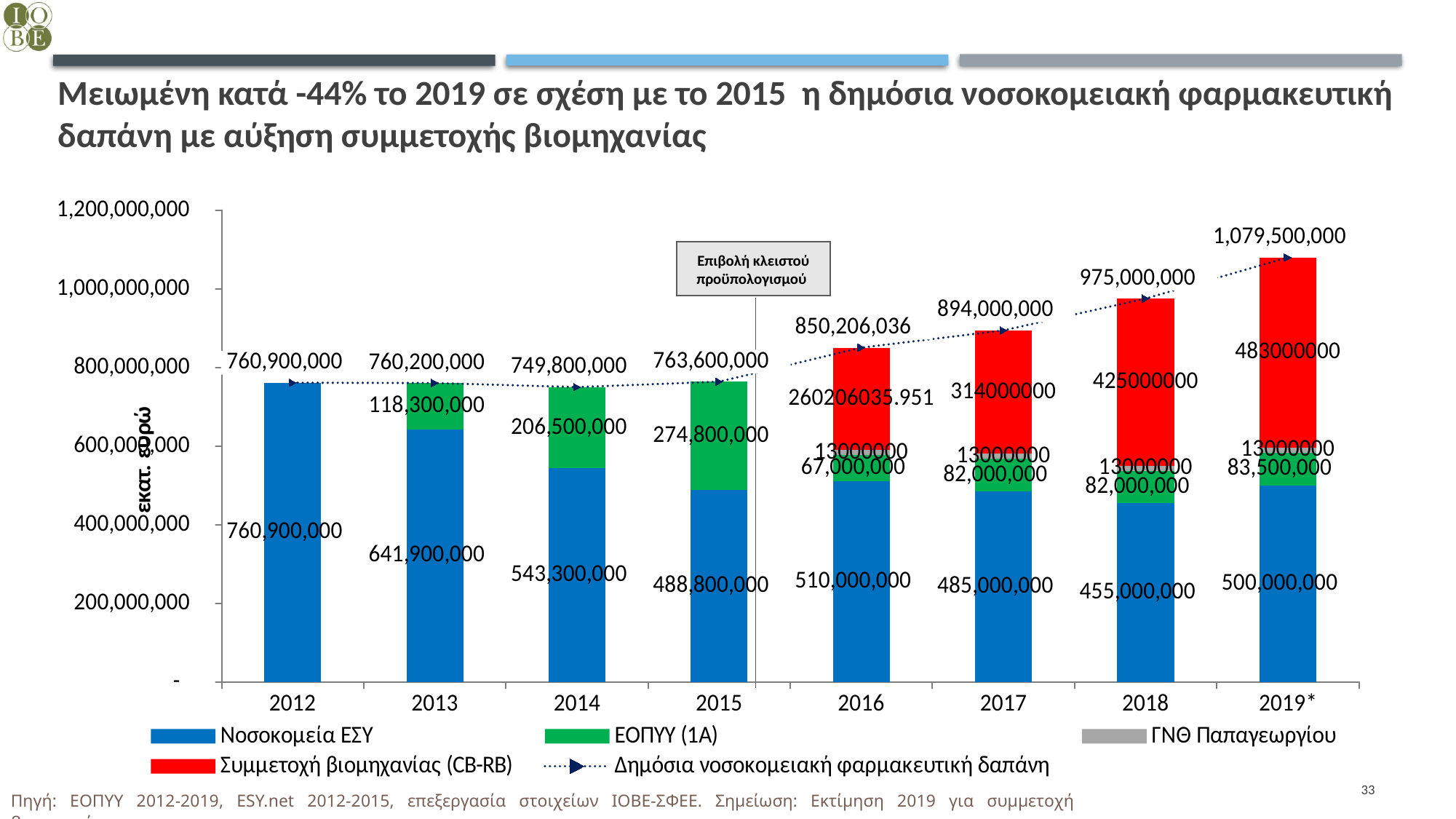
What is the value for ΕΟΠΥΥ (1Α) in 2015? 274,800,000 How many series does the legend list? 5 In which year is the Δημόσια νοσοκομειακή φαρμακευτική δαπάνη line highest? 2019* What is the value for Συμμετοχή βιομηχανίας (CB-RB) in 2019*? 483000000 What is the value for ΓΝΘ Παπαγεωργίου in 2017? 13000000 In which year is the value for Νοσοκομεία ΕΣΥ lowest? 2018 Does the value for Νοσοκομεία ΕΣΥ rise or fall from 2012 to 2015? fall What is the difference between the Νοσοκομεία ΕΣΥ values for 2012 and 2013? 119,000,000 How many years are shown on the x axis? 8 What is the value for Νοσοκομεία ΕΣΥ in 2012? 760,900,000 Which year has the larger ΕΟΠΥΥ (1Α) value, 2014 or 2015? 2015 What is the value of the Δημόσια νοσοκομειακή φαρμακευτική δαπάνη line in 2018? 975,000,000